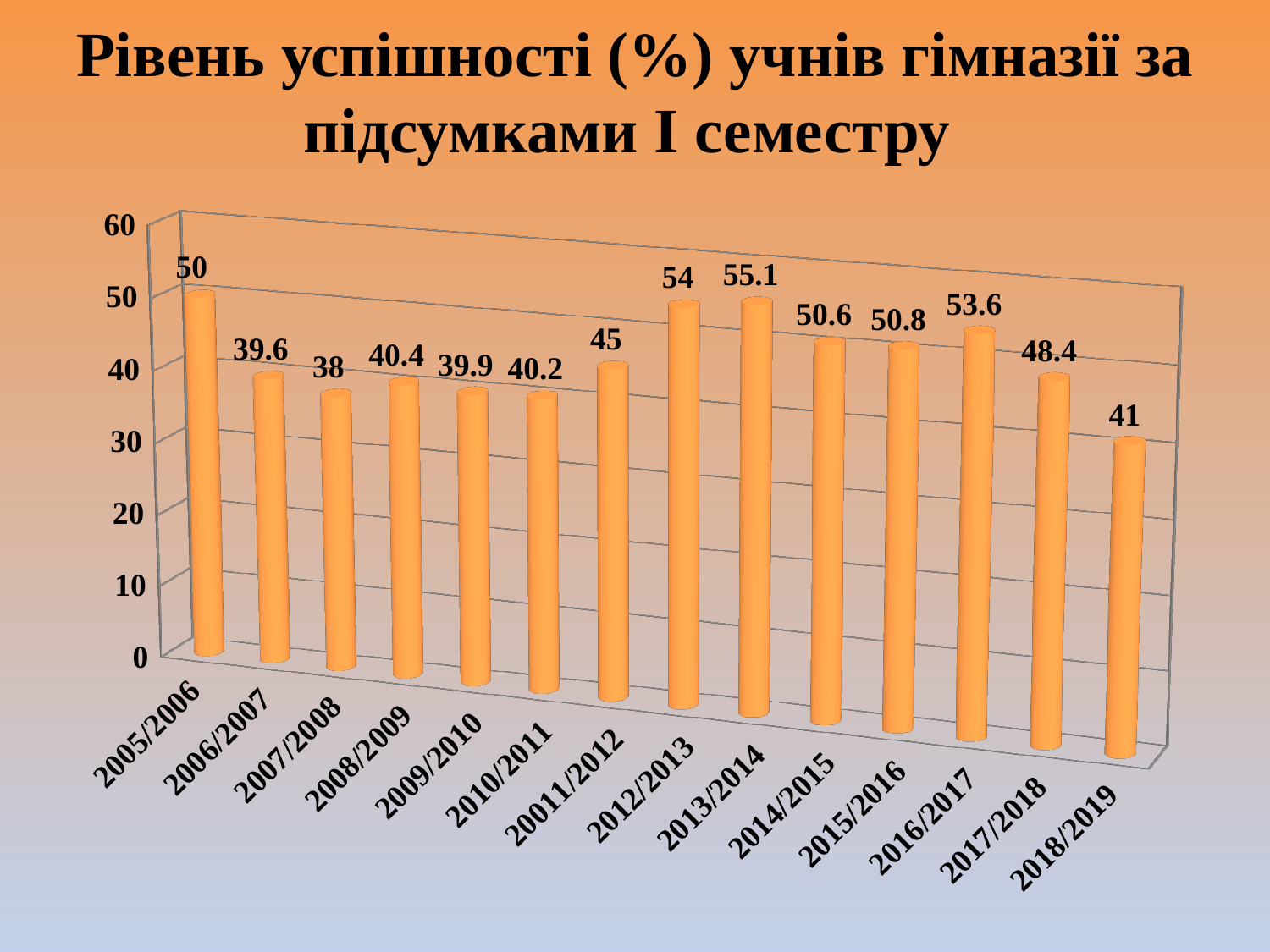
Which school year has the lowest value? 2007/2008 What is the difference between the values for 2012/2013 and 2007/2008? 16 Is the value for 2017/2018 greater or less than 40? greater Which is larger, the value for 2014/2015 or the value for 2015/2016? 2015/2016 How many school years are shown on the x axis? 14 What is the value for 2018/2019? 41 Do the values rise or fall from 2016/2017 to 2018/2019? fall Which school year has the highest value? 2013/2014 What kind of chart is shown on the slide? bar chart What is the value for 2005/2006? 50 What is the value for 2013/2014? 55.1 What is the value for 2016/2017? 53.6